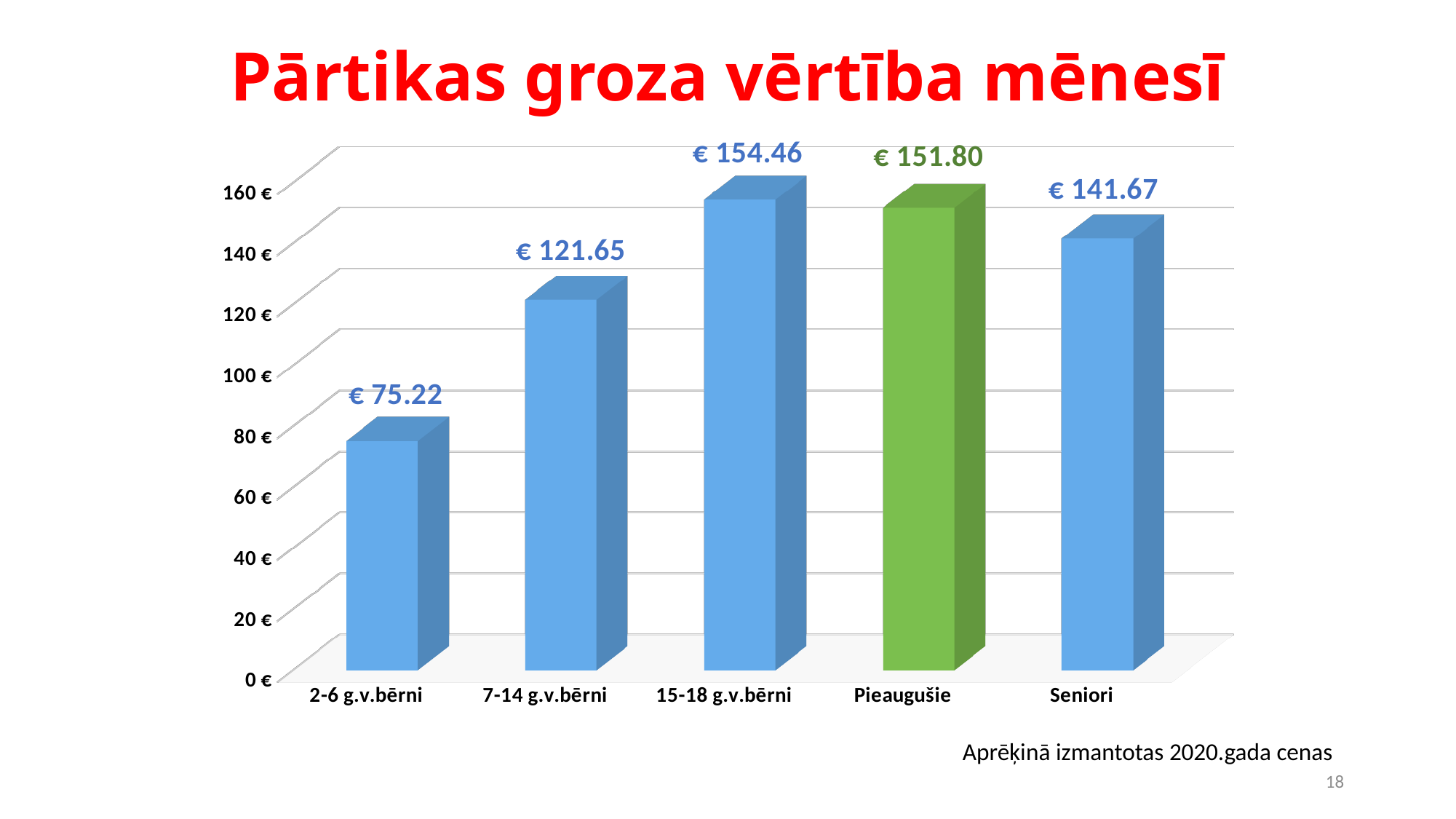
What kind of chart is shown on the slide? bar chart What is the value for Seniori? € 141.67 Which bar is coloured green rather than blue? Pieaugušie What is the value for Pieaugušie? € 151.80 What is the value for 2-6 g.v.bērni? € 75.22 Which category has the highest value? 15-18 g.v.bērni Which category has the lowest value? 2-6 g.v.bērni Which is larger, the value for Pieaugušie or the value for Seniori? Pieaugušie What is the difference between the values for 7-14 g.v.bērni and 2-6 g.v.bērni? € 46.43 What is the difference between the values for 15-18 g.v.bērni and Seniori? € 12.79 How many categories are shown in the chart? 5 Is the value for 7-14 g.v.bērni greater or less than 100 €? greater